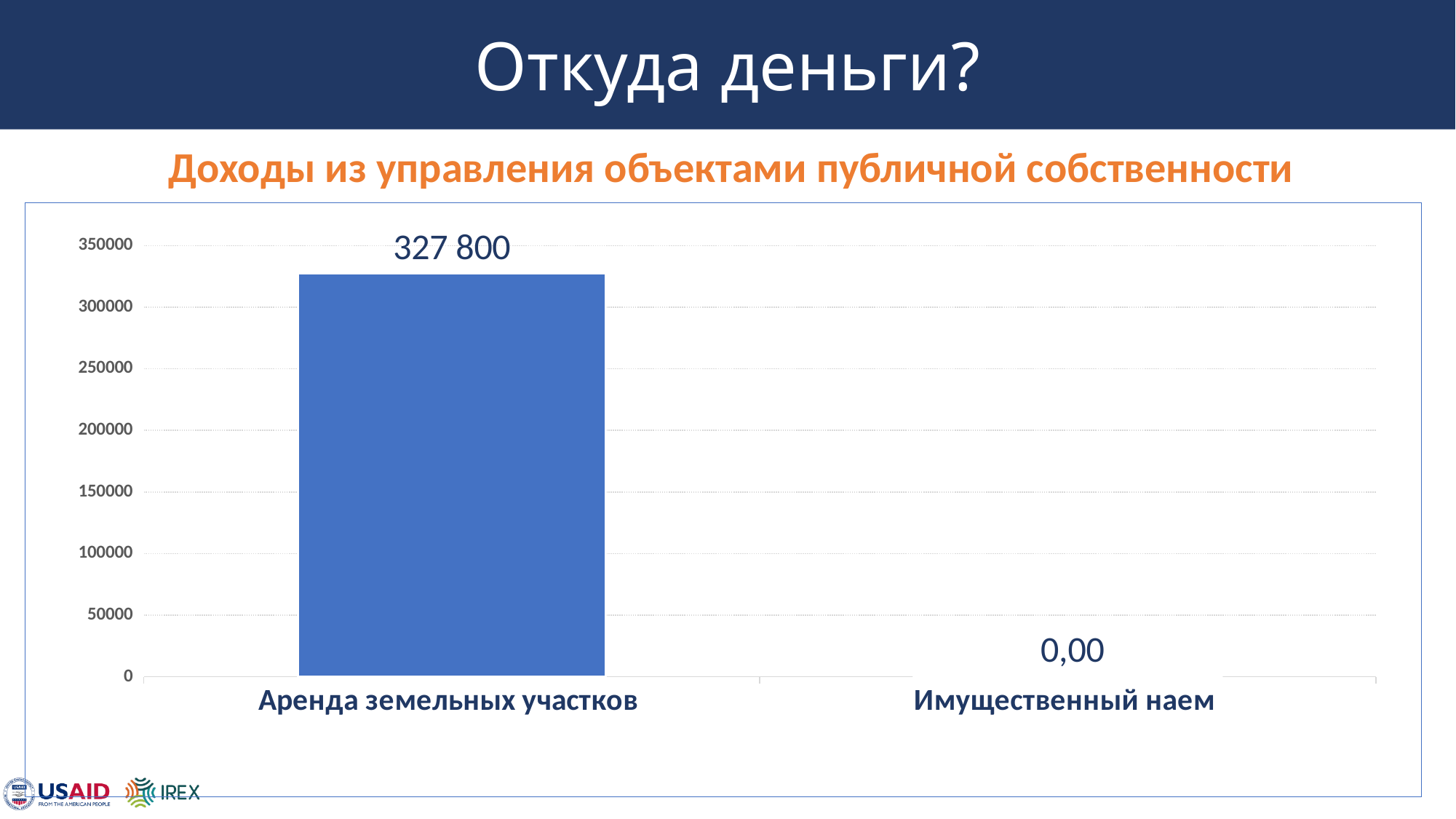
What kind of chart is shown on the slide? bar chart How many categories are shown on the x axis? 2 What is the title shown above the chart? Доходы из управления объектами публичной собственности What is the difference between the values for Аренда земельных участков and Имущественный наем? 327 800 What is the highest tick value shown on the vertical axis? 350000 Which category has the lowest value? Имущественный наем Which is larger: the value for Аренда земельных участков or the value for Имущественный наем? Аренда земельных участков What is the value for Имущественный наем? 0,00 Which category has the highest value? Аренда земельных участков Is the value for Аренда земельных участков greater or less than 300000? greater Is the value for Аренда земельных участков greater or less than 350000? less What is the value for Аренда земельных участков? 327 800